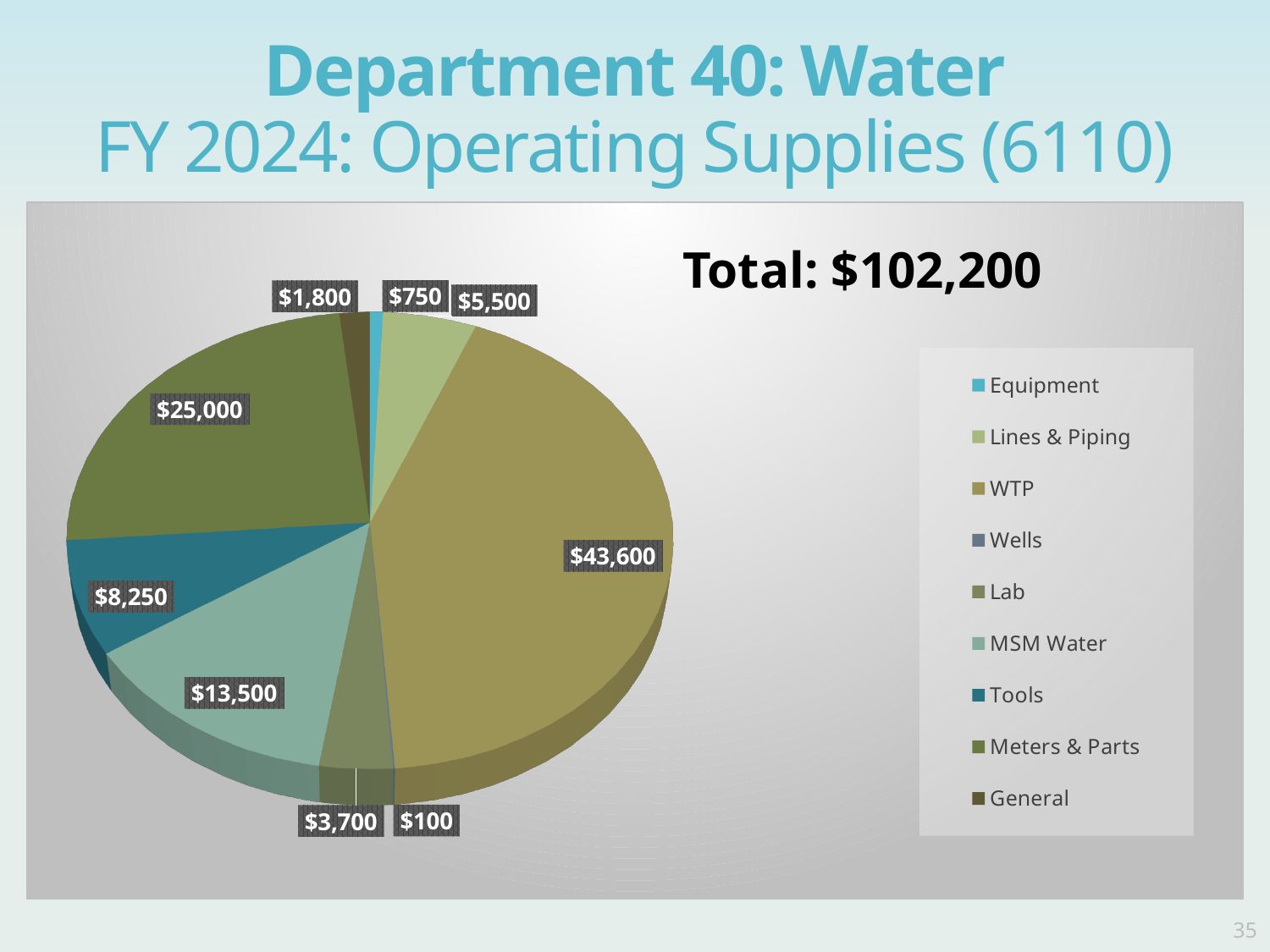
Which is larger, MSM Water or Tools? MSM Water What total is stated on the slide for the chart? $102,200 What is the value for MSM Water? $13,500 What is the difference between the WTP value and the Meters & Parts value? $18,600 What is the value for WTP? $43,600 What kind of chart is shown on the slide? Pie chart Which category has the largest slice of the pie? WTP What is the value for Tools? $8,250 How many categories are shown in the pie chart? 9 What is the value for Equipment? $750 What is the value for Meters & Parts? $25,000 Which category has the smallest slice of the pie? Wells